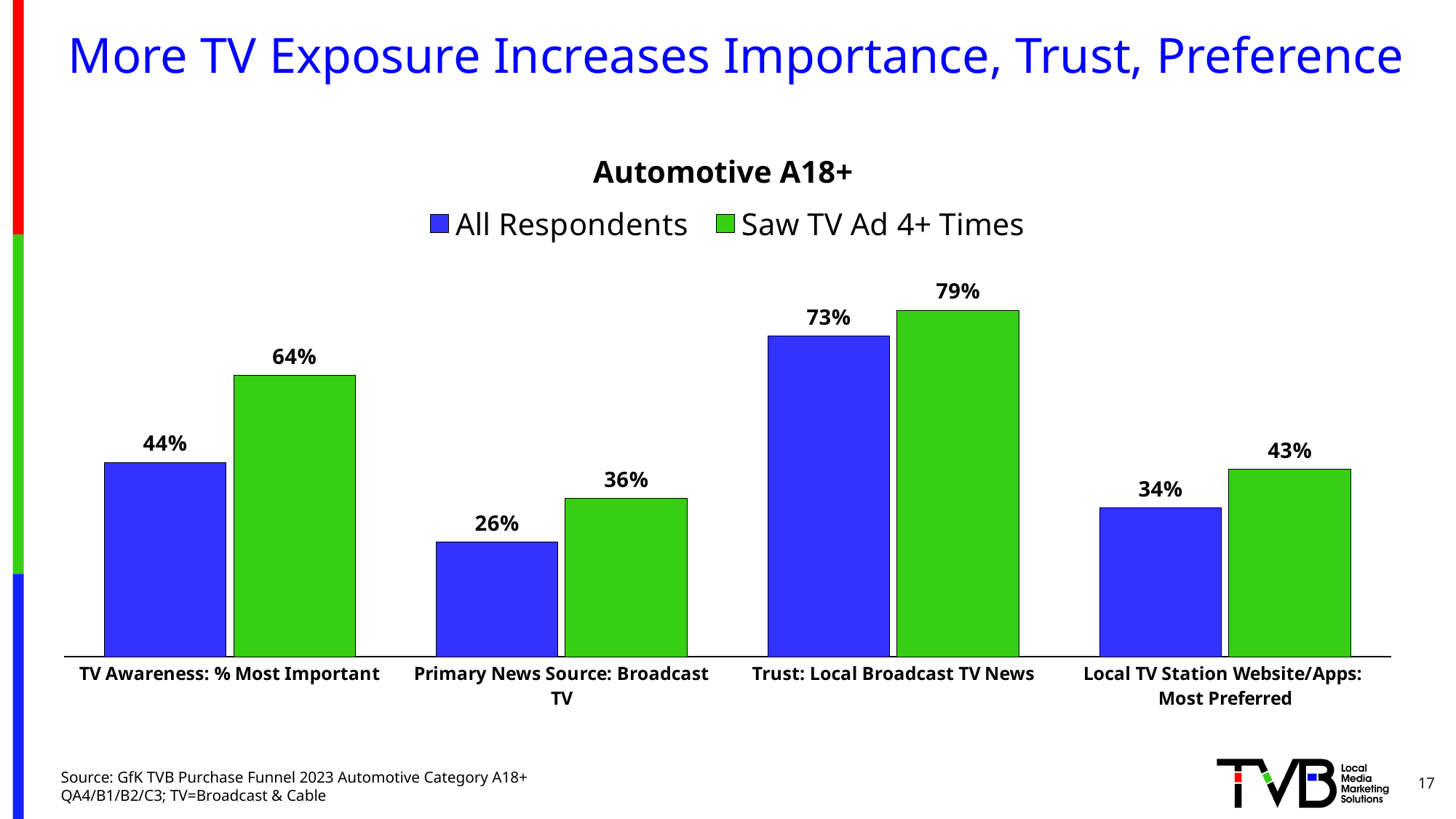
What is the difference between Saw TV Ad 4+ Times and All Respondents in the Local TV Station Website/Apps: Most Preferred category? 9% What is the value for All Respondents in the TV Awareness: % Most Important category? 44% How many categories are shown on the x axis? 4 Which category has the lowest value for Saw TV Ad 4+ Times? Primary News Source: Broadcast TV What is the difference between Saw TV Ad 4+ Times and All Respondents in the TV Awareness: % Most Important category? 20% How many series does the legend list? 2 Which is larger: All Respondents for Trust: Local Broadcast TV News or Saw TV Ad 4+ Times for TV Awareness: % Most Important? All Respondents for Trust: Local Broadcast TV News What is the value for Saw TV Ad 4+ Times in the Primary News Source: Broadcast TV category? 36% What is the value for Saw TV Ad 4+ Times in the Trust: Local Broadcast TV News category? 79% What kind of chart is shown on the slide? Bar chart What is the value for All Respondents in the Local TV Station Website/Apps: Most Preferred category? 34% Which category has the highest value for All Respondents? Trust: Local Broadcast TV News